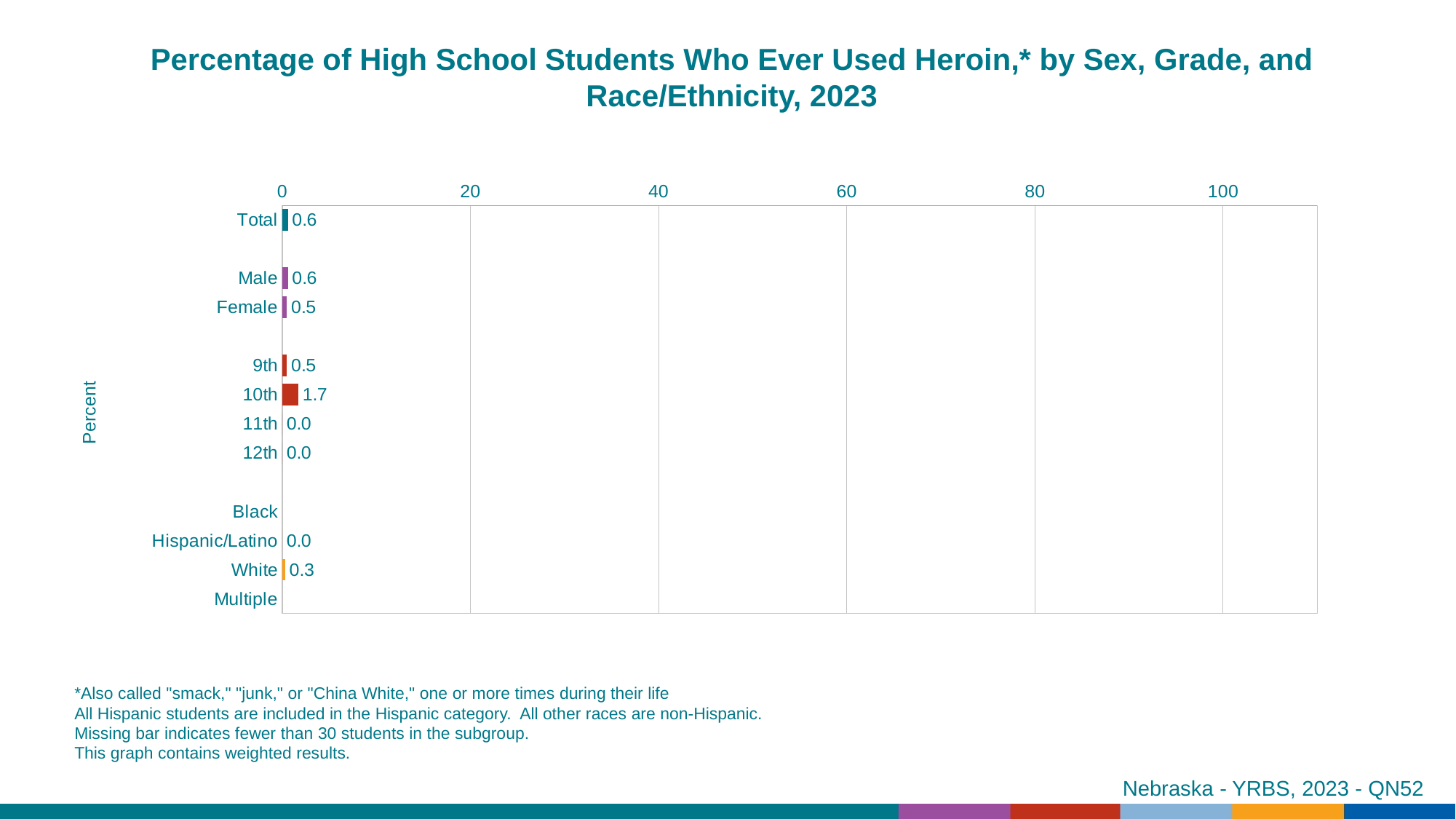
What is the value for Female? 0.5 What is the value for Hispanic/Latino? 0.0 What kind of chart is shown on the slide? bar chart What is the value for 10th grade? 1.7 Which category has the highest value? 10th What is the value for White? 0.3 Which is larger, the value for Male or the value for Female? Male What is the difference between the values for 10th and 9th grade? 1.2 Is the value for 10th grade greater or less than 20? less What is the label of the vertical axis? Percent How many categories are listed on the vertical axis? 12 What is the value for Total? 0.6